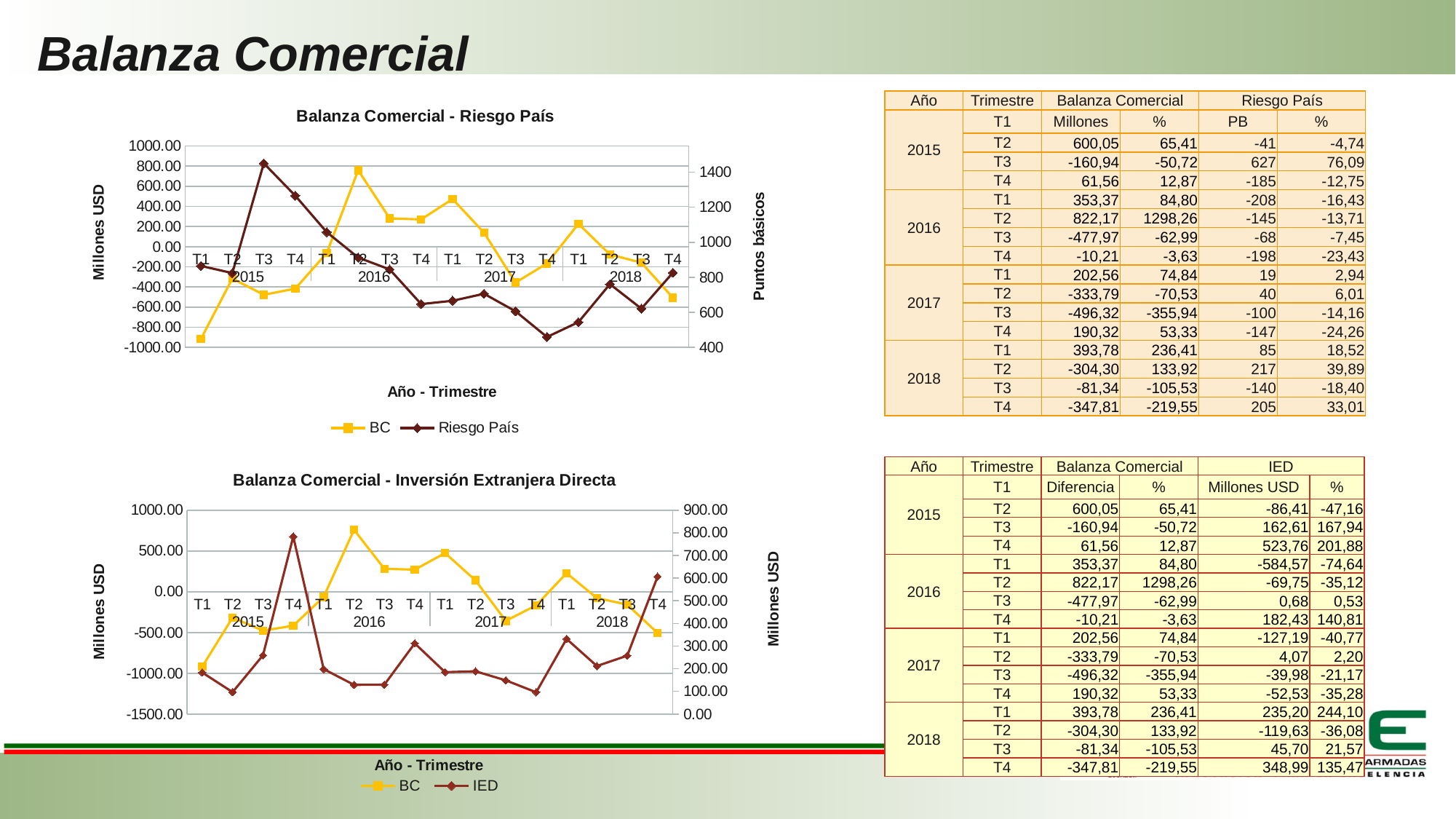
In the top chart 'Balanza Comercial - Riesgo País', is the Riesgo País value for 2017 T4 greater or less than 600? less In the bottom chart 'Balanza Comercial - Inversión Extranjera Directa', is the IED value for 2015 T4 greater or less than 700.00? greater In the bottom chart 'Balanza Comercial - Inversión Extranjera Directa', in which year and quarter does the IED series reach its highest value? 2015 T4 In the top chart 'Balanza Comercial - Riesgo País', in which year and quarter does the BC series reach its highest value? 2016 T2 What kind of chart is the top chart titled 'Balanza Comercial - Riesgo País'? line chart How many series does the legend of the bottom chart 'Balanza Comercial - Inversión Extranjera Directa' list? 2 In the top chart 'Balanza Comercial - Riesgo País', in which year and quarter does the BC series reach its lowest value? 2015 T1 In the top chart 'Balanza Comercial - Riesgo País', in which year and quarter does the Riesgo País series reach its highest value? 2015 T3 In the top chart 'Balanza Comercial - Riesgo País', how many quarterly points are plotted for the BC series? 16 In the top chart 'Balanza Comercial - Riesgo País', is the BC value for 2016 T2 greater or less than 600.00? greater What is the label of the right-hand vertical axis of the top chart 'Balanza Comercial - Riesgo País'? Puntos básicos In the top chart 'Balanza Comercial - Riesgo País', does the BC series rise or fall from 2016 T2 to 2016 T4? fall